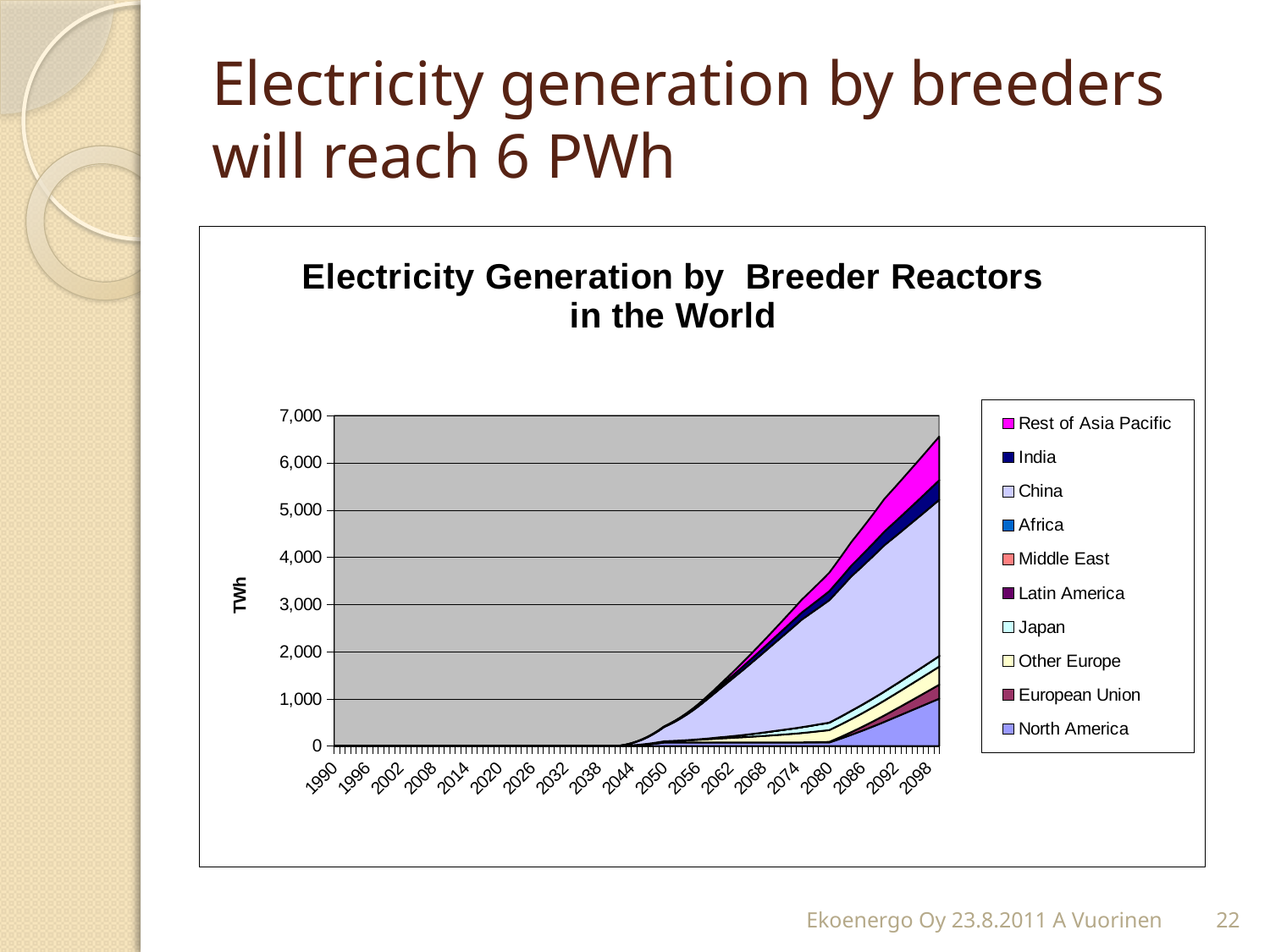
What kind of chart is shown on the slide? Stacked area chart Is the total electricity generation in 2098 greater or less than 6,000 TWh? greater Does total electricity generation by breeder reactors rise or fall along the x axis from 2044 to 2098? Rise Is the total electricity generation in 2080 greater or less than 2,000 TWh? greater How many series does the chart legend list? 10 How many year labels are shown on the x axis? 19 What is the title of the chart? Electricity Generation by Breeder Reactors in the World What is the highest value shown on the y axis? 7,000 What unit is shown on the y-axis label of the chart? TWh Which series is plotted at the bottom of the stacked areas? North America Which region contributes the largest share of electricity generation in 2098? China Is the total electricity generation in 2050 greater or less than 1,000 TWh? less